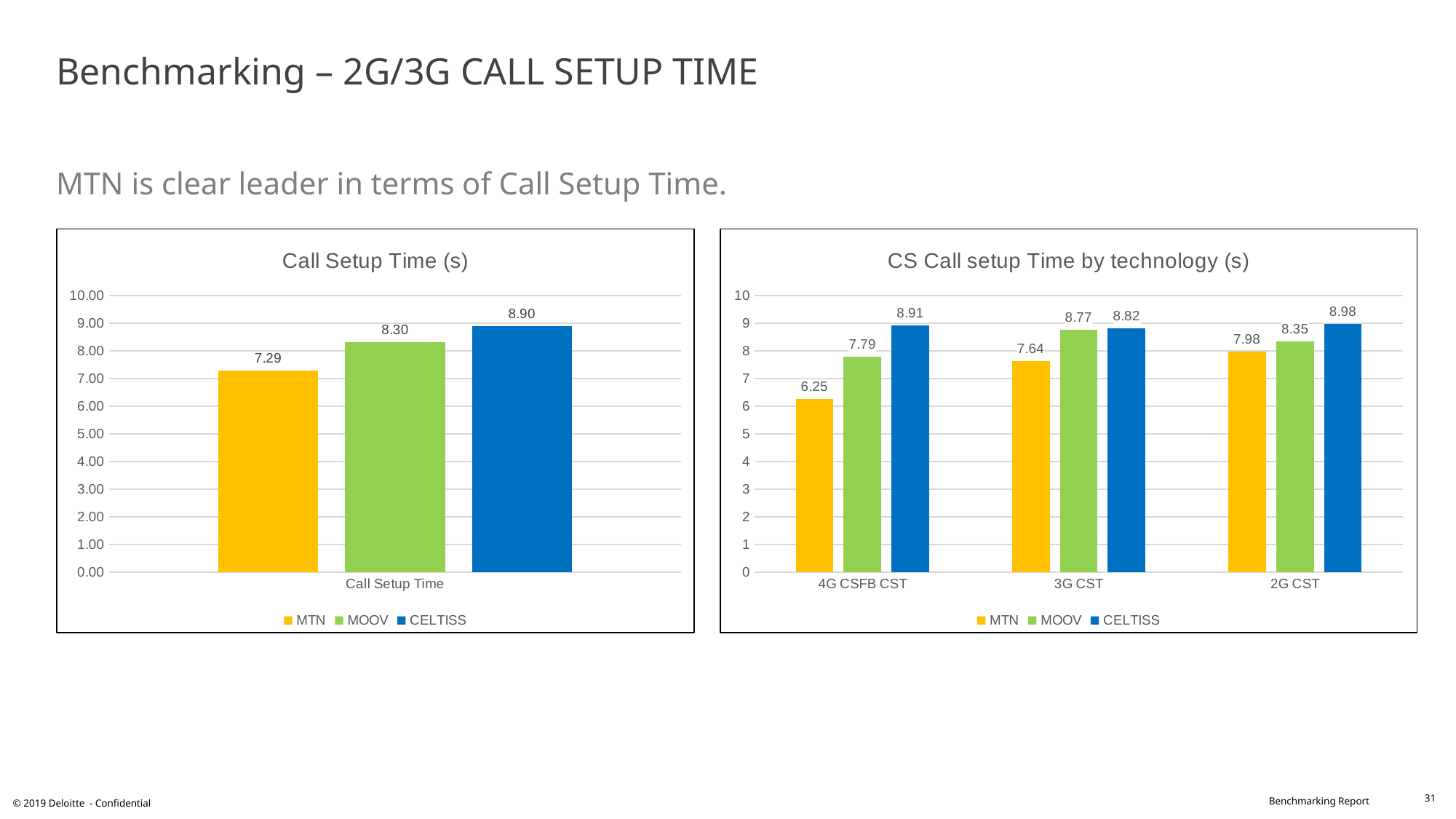
In the 'CS Call setup Time by technology (s)' chart, which is larger for 2G CST: MOOV or CELTISS? CELTISS In the 'CS Call setup Time by technology (s)' chart, what is the value for MTN for 4G CSFB CST? 6.25 In the 'Call Setup Time (s)' chart, how many series does the legend list? 3 In the 'Call Setup Time (s)' chart, which operator has the highest call setup time? CELTISS In the 'CS Call setup Time by technology (s)' chart, what is the difference between CELTISS and MTN for 4G CSFB CST? 2.66 In the 'CS Call setup Time by technology (s)' chart, what is the value for MOOV for 3G CST? 8.77 In the 'CS Call setup Time by technology (s)' chart, which operator has the lowest value for 2G CST? MTN What kind of chart is the 'CS Call setup Time by technology (s)' chart? Bar chart In the 'CS Call setup Time by technology (s)' chart, what colour represents CELTISS? Blue In the 'Call Setup Time (s)' chart, what is the difference between CELTISS and MTN? 1.61 In the 'CS Call setup Time by technology (s)' chart, how many technology categories are shown on the x axis? 3 In the 'Call Setup Time (s)' chart, what is the value for MTN? 7.29